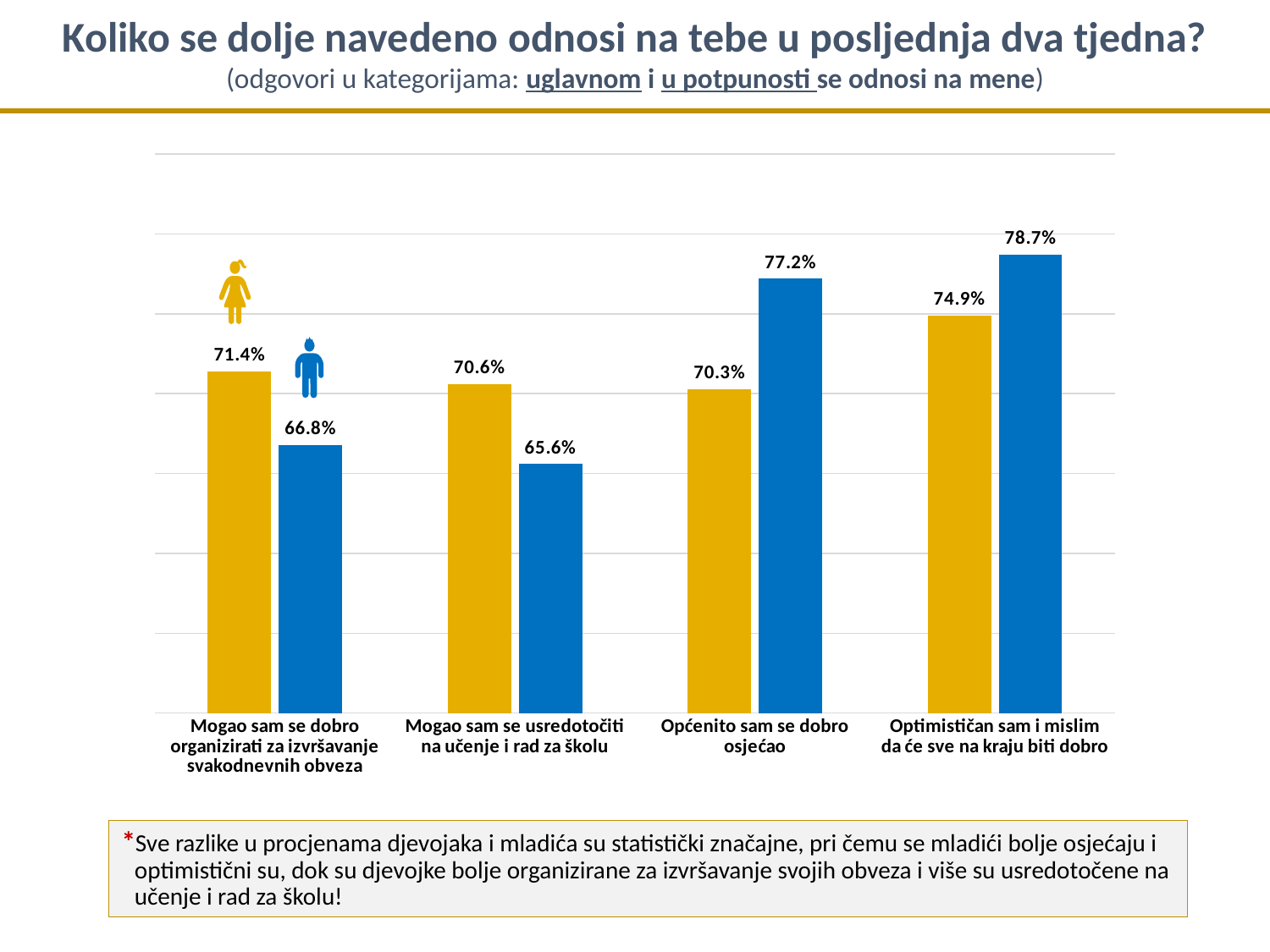
What is the value of the blue (boy) bar for 'Općenito sam se dobro osjećao'? 77.2% Which colour represents girls in the chart? yellow What is the value of the blue (boy) bar for 'Mogao sam se usredotočiti na učenje i rad za školu'? 65.6% Which bar has the highest value in the chart? Blue (boy) bar for 'Optimističan sam i mislim da će sve na kraju biti dobro' (78.7%) Which bar has the lowest value in the chart? Blue (boy) bar for 'Mogao sam se usredotočiti na učenje i rad za školu' (65.6%) What type of chart is shown on the slide? bar chart What is the value of the yellow (girl) bar for 'Mogao sam se dobro organizirati za izvršavanje svakodnevnih obveza'? 71.4% How many data series are plotted in the chart? 2 What is the value of the yellow (girl) bar for 'Optimističan sam i mislim da će sve na kraju biti dobro'? 74.9% For 'Općenito sam se dobro osjećao', which bar is larger, the yellow (girl) or the blue (boy)? blue (boy) What is the difference between the yellow and blue bars for 'Mogao sam se dobro organizirati za izvršavanje svakodnevnih obveza'? 4.6 percentage points How many categories are shown on the x axis of the chart? 4